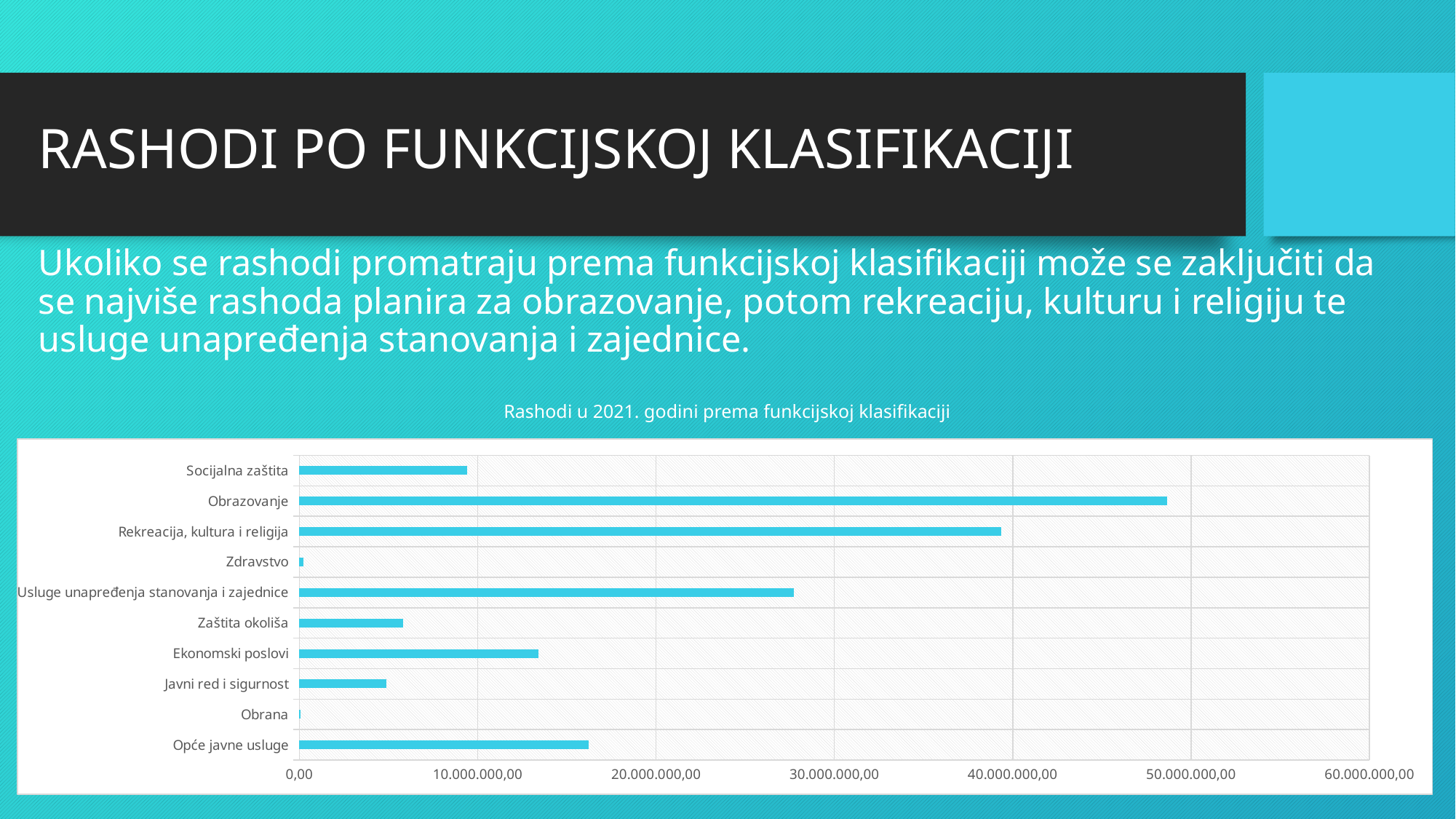
How many categories are plotted in the chart? 10 Is the value for Opće javne usluge greater or less than 10.000.000,00? greater Which category has the highest value? Obrazovanje Is the value for Usluge unapređenja stanovanja i zajednice greater or less than 30.000.000,00? less What is the title of the chart? Rashodi u 2021. godini prema funkcijskoj klasifikaciji Which category has the lowest value? Obrana Which is larger, the value for Zaštita okoliša or the value for Socijalna zaštita? Socijalna zaštita Is the value for Obrazovanje greater or less than 40.000.000,00? greater What kind of chart is shown on the slide? Bar chart Which is larger, the value for Ekonomski poslovi or the value for Javni red i sigurnost? Ekonomski poslovi